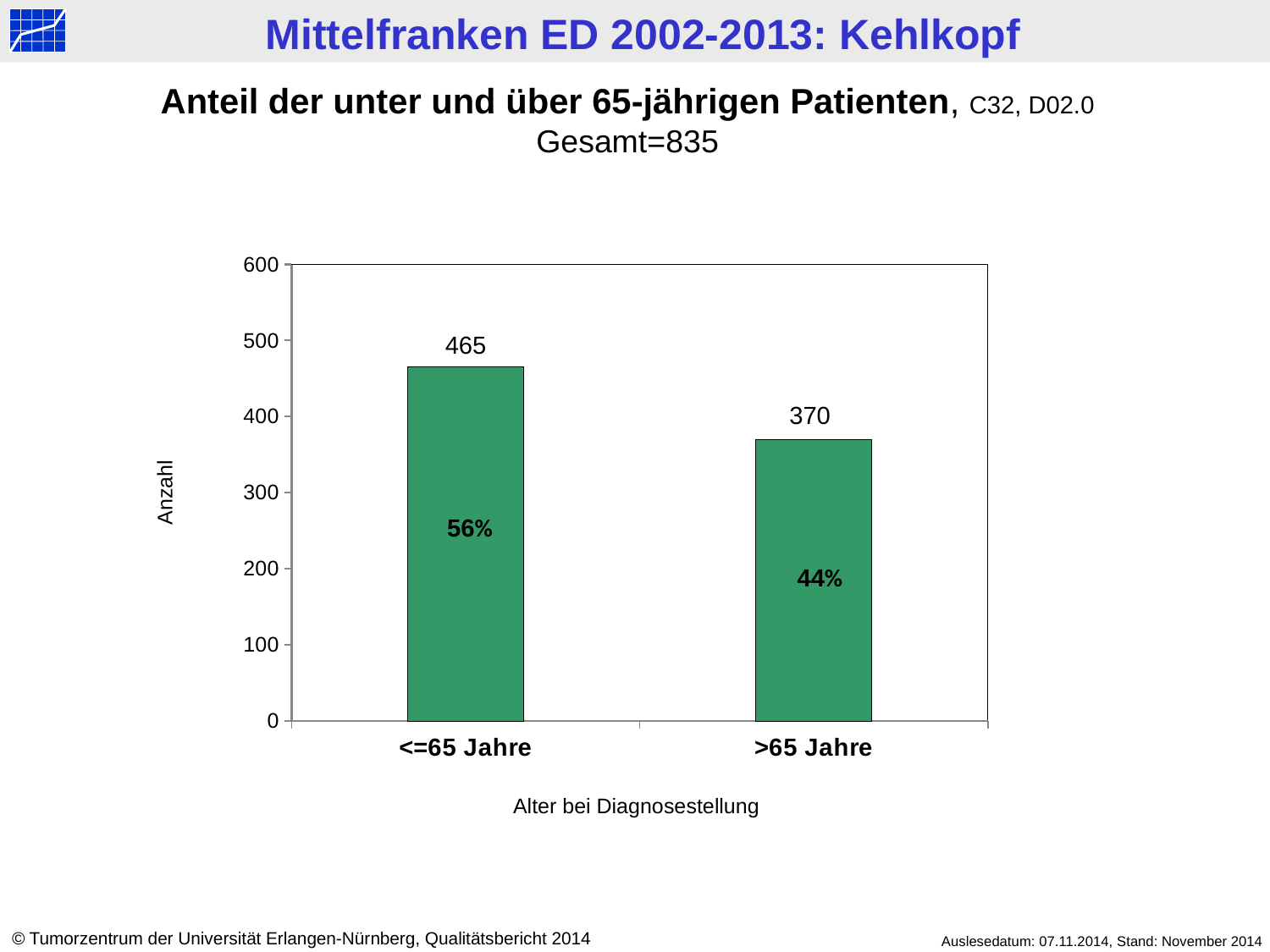
What kind of chart is shown on the slide? bar chart What is the label of the y axis? Anzahl What percentage is shown inside the >65 Jahre bar? 44% What percentage is shown inside the <=65 Jahre bar? 56% Is the value for >65 Jahre greater or less than 400? less What is the value for the >65 Jahre category? 370 How many categories are shown on the x axis? 2 What is the difference between the values for <=65 Jahre and >65 Jahre? 95 Which is larger, the value for <=65 Jahre or for >65 Jahre? <=65 Jahre Which category has the highest value? <=65 Jahre What is the value for the <=65 Jahre category? 465 Which category has the lowest value? >65 Jahre